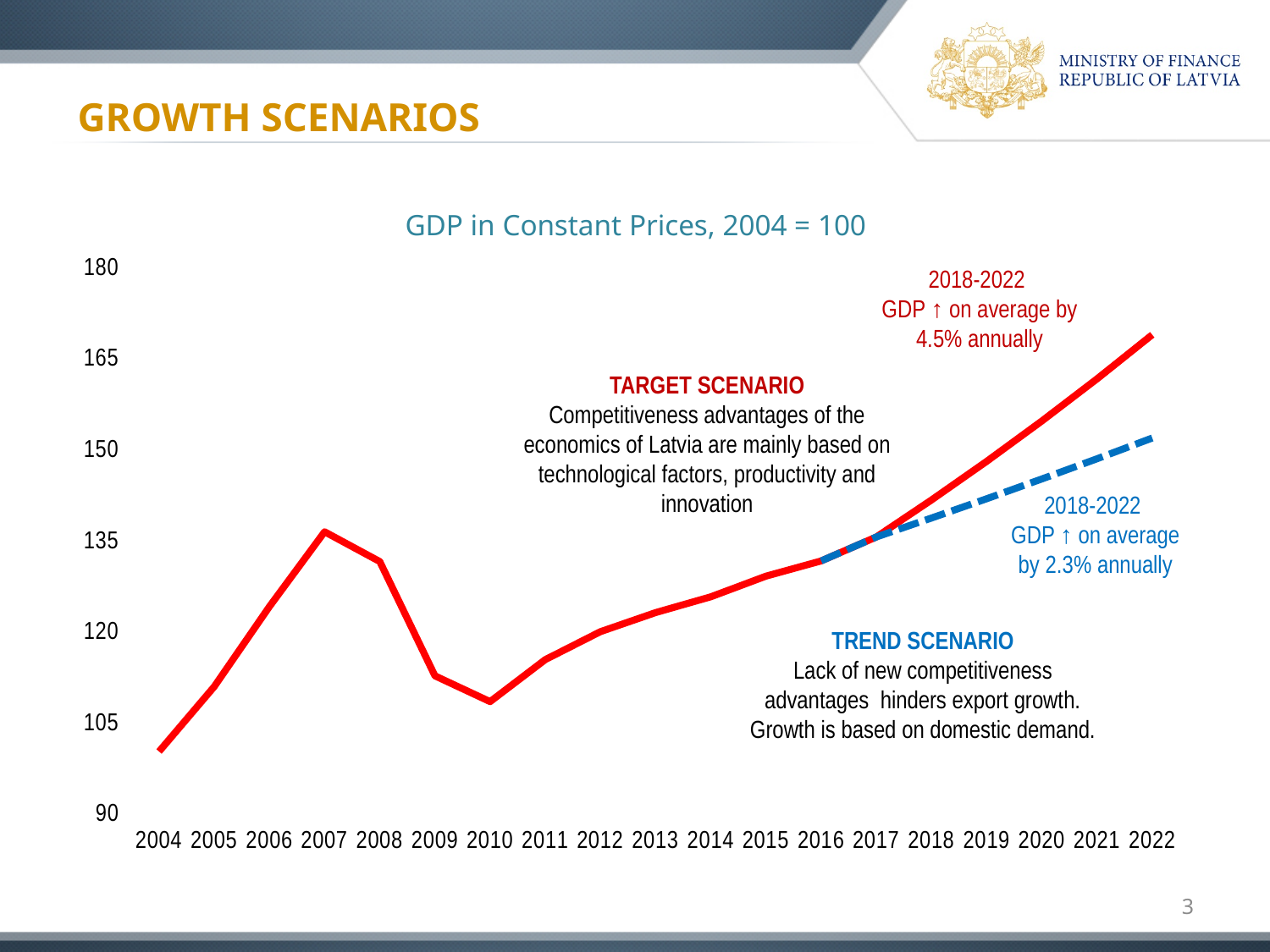
Is the GDP index value for 2010 greater or less than 120? less According to the chart annotation, by how much does GDP grow on average annually in 2018-2022 under the target scenario? 4.5% annually What kind of chart is shown on the slide? line chart What is the title of the chart? GDP in Constant Prices, 2004 = 100 Is the 2022 value of the target scenario greater or less than 150? greater Does the GDP index rise or fall between 2007 and 2010? fall Is the GDP index value for 2007 greater or less than 120? greater How many years are shown on the x axis of the chart? 19 According to the chart annotation, by how much does GDP grow on average annually in 2018-2022 under the trend scenario? 2.3% annually Which year has the lowest GDP index value on the chart? 2004 Which scenario has the higher GDP index value in 2022, the target scenario or the trend scenario? target scenario